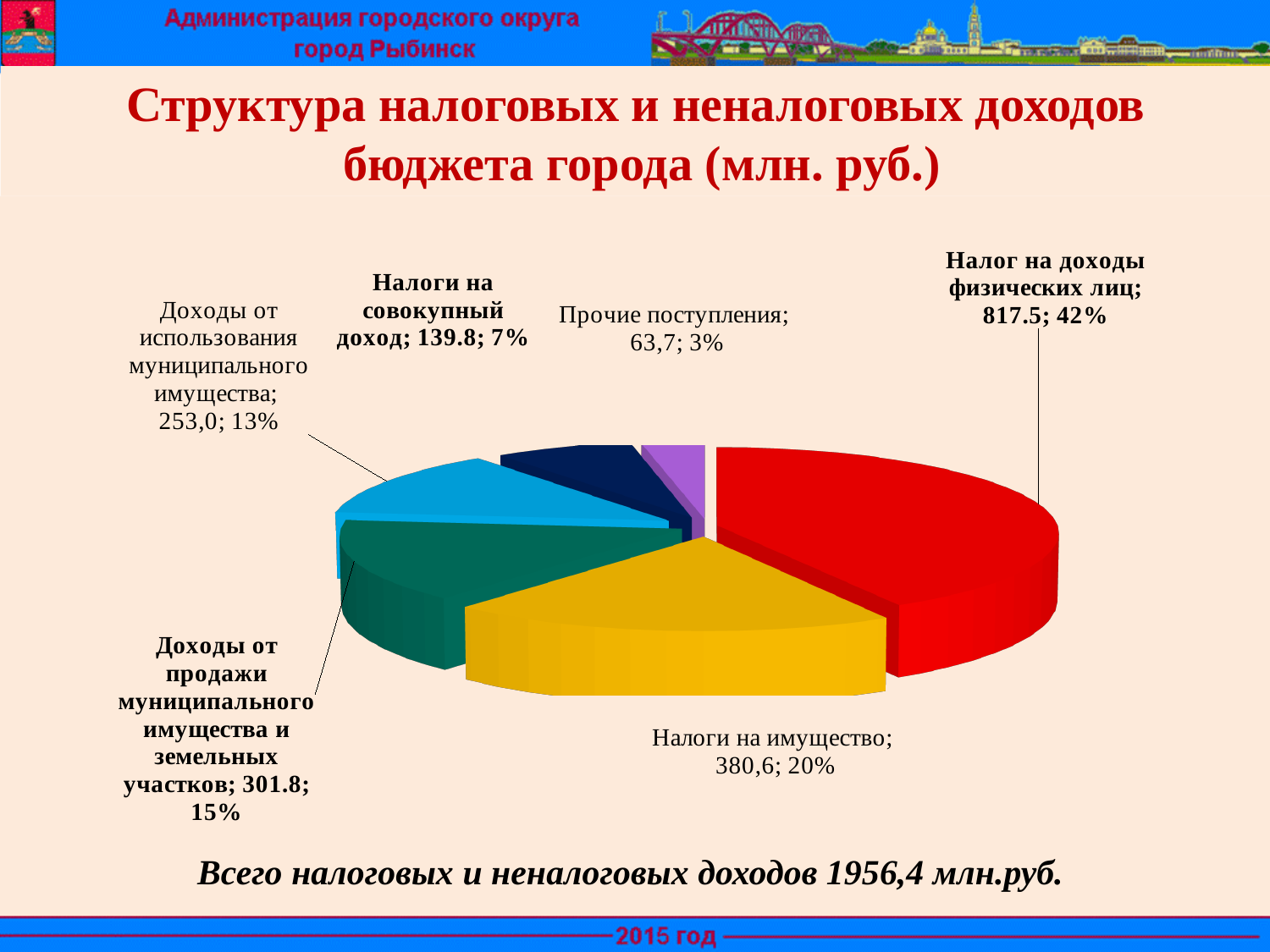
What is the difference between the values for Налог на доходы физических лиц and Налоги на совокупный доход? 677.7 What share of the pie does Налоги на совокупный доход represent? 7% What type of chart is shown on the slide? pie chart What share of the pie does Доходы от продажи муниципального имущества и земельных участков represent? 15% What is the value for Налог на доходы физических лиц? 817.5 What is the value for Налоги на имущество? 380,6 What is the value for Прочие поступления? 63,7 Which category has the largest slice of the pie? Налог на доходы физических лиц What is the value for Доходы от использования муниципального имущества? 253,0 How many slices does the pie chart have? 6 Which category has the smallest slice of the pie? Прочие поступления Which is larger: Налоги на имущество or Доходы от использования муниципального имущества? Налоги на имущество